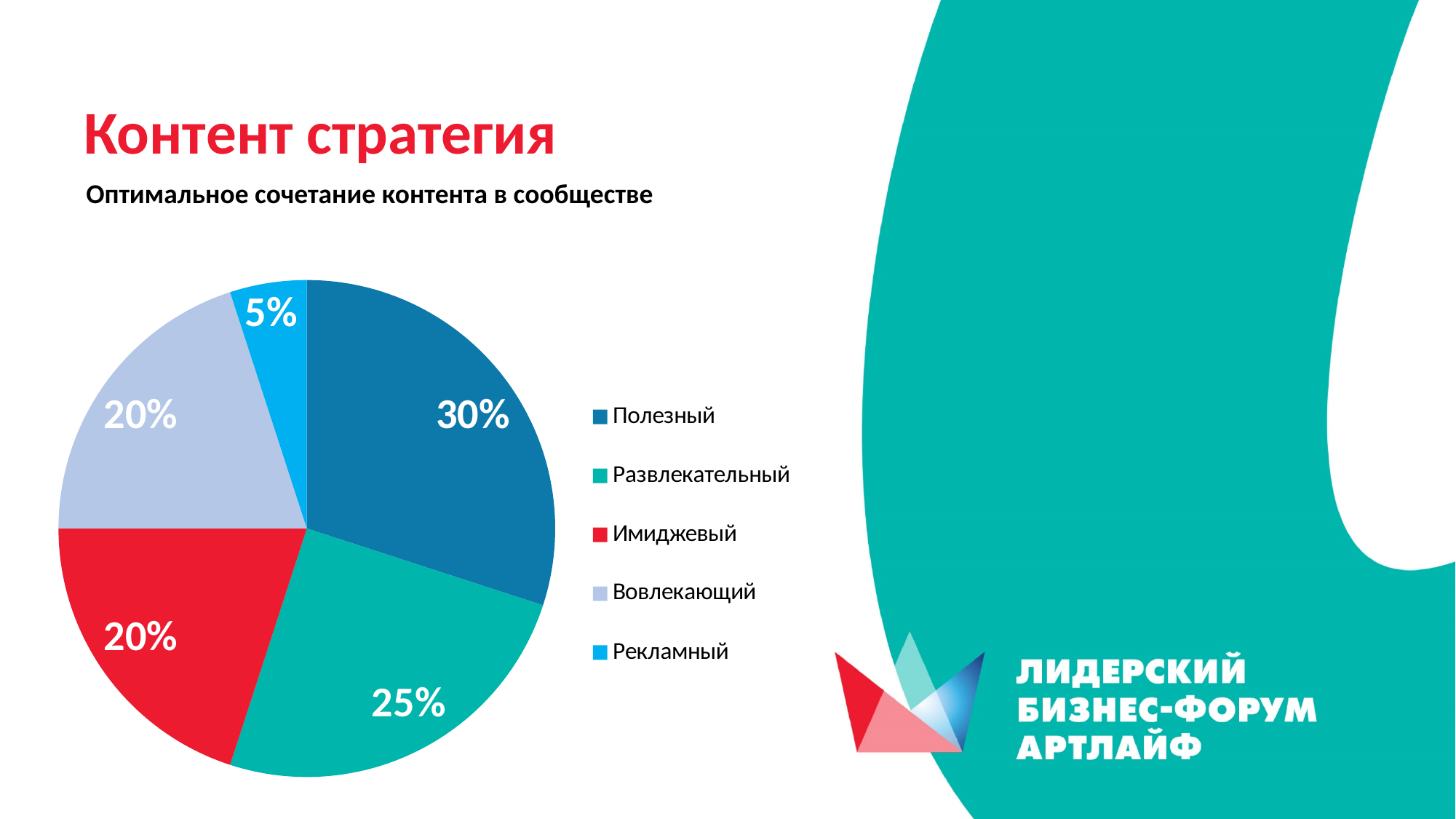
What is the difference between the shares of Вовлекающий and Рекламный? 15% How many categories does the pie chart show? 5 Which category has the largest slice of the pie? Полезный What is the difference between the shares of Полезный and Развлекательный? 5% What share of the pie does Полезный have? 30% What share of the pie does Рекламный have? 5% What share of the pie does Имиджевый have? 20% Which is larger, the share of Развлекательный or the share of Имиджевый? Развлекательный Which category has the smallest slice of the pie? Рекламный What share of the pie does Развлекательный have? 25% What kind of chart is shown on the slide? Pie chart What is the subtitle printed above the chart? Оптимальное сочетание контента в сообществе